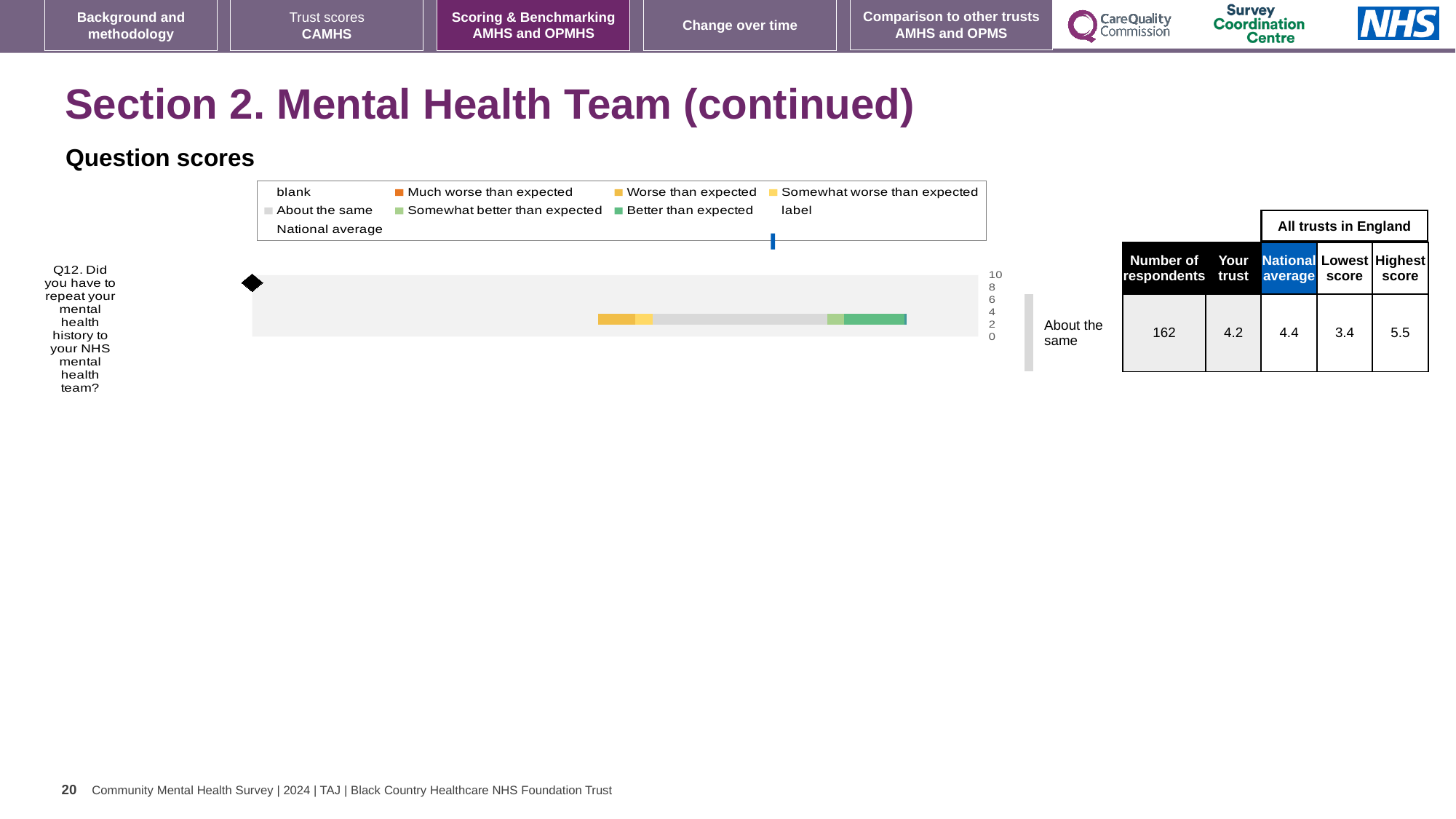
In the table beside the chart, what is the lowest score among all trusts in England for Q12? 3.4 What benchmark label is shown to the right of the Q12 bar? About the same Which question is plotted in the question scores chart? Q12. Did you have to repeat your mental health history to your NHS mental health team? What kind of chart is used to show the Q12 question score? bar chart In the table beside the chart, what is the highest score among all trusts in England for Q12? 5.5 In the table beside the chart, what is the national average score for Q12? 4.4 In the table beside the chart, what is the 'Your trust' score for Q12? 4.2 For Q12, what is the difference between the national average and the 'Your trust' score? 0.2 In the table beside the chart, how many respondents answered Q12? 162 For Q12, which is larger: the 'Your trust' score or the national average? National average How many survey questions are plotted in the question scores chart? 1 For Q12, what is the difference between the highest score and the lowest score among all trusts in England? 2.1